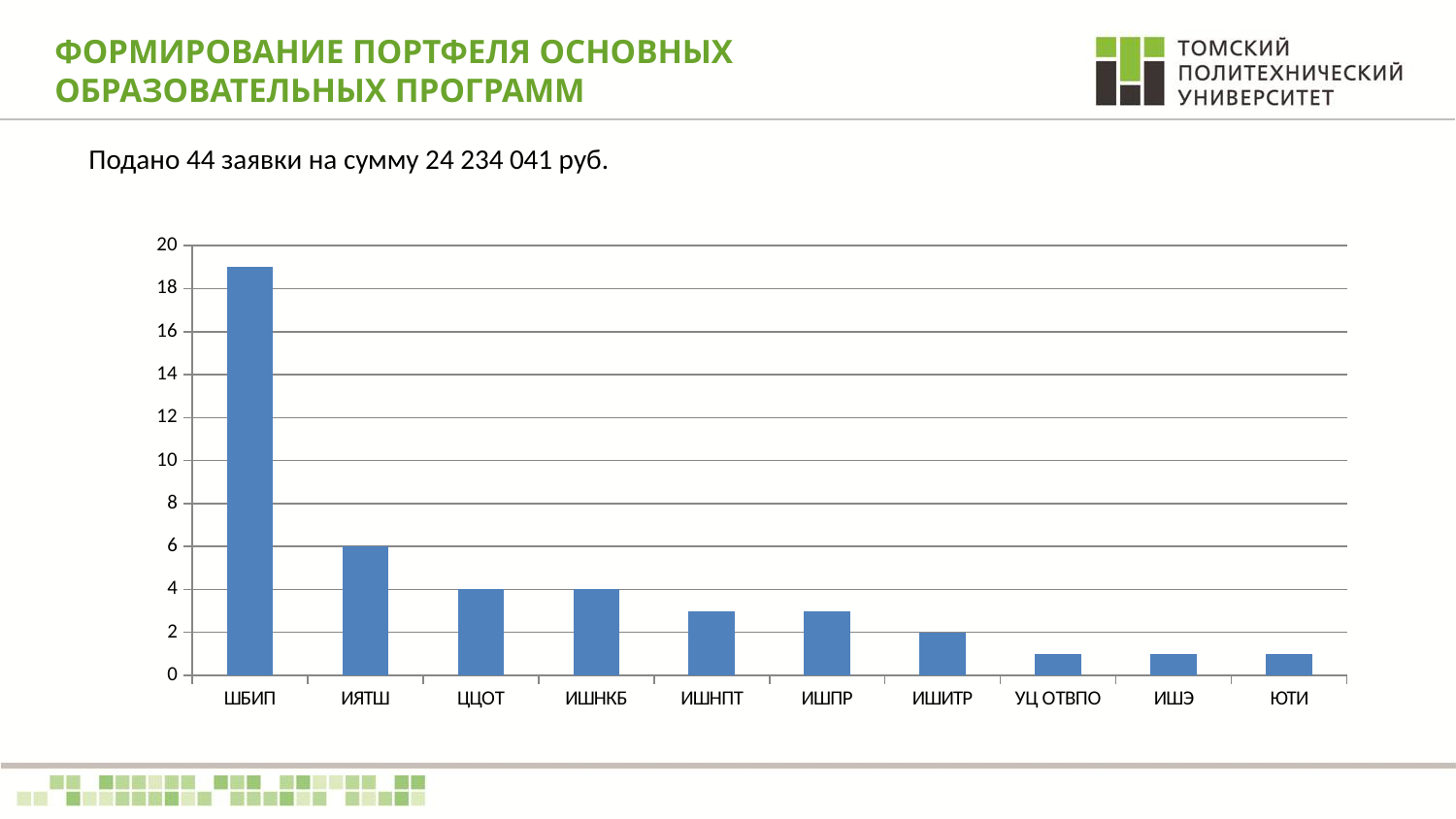
Is the value for ИШНПТ greater or less than 4? less What is the value for ИШИТР? 2 Which is larger, the value for ШБИП or the value for ИЯТШ? ШБИП What is the difference between the values for ИЯТШ and ЦЦОТ? 2 Is the value for ЮТИ greater or less than 2? less What kind of chart is shown on the slide? bar chart Which category has the highest bar in the chart? ШБИП What is the value for ЦЦОТ? 4 Is the value for ШБИП greater or less than 18? greater What is the value for ИШНКБ? 4 How many categories are shown on the x axis of the chart? 10 What is the value for ИЯТШ? 6